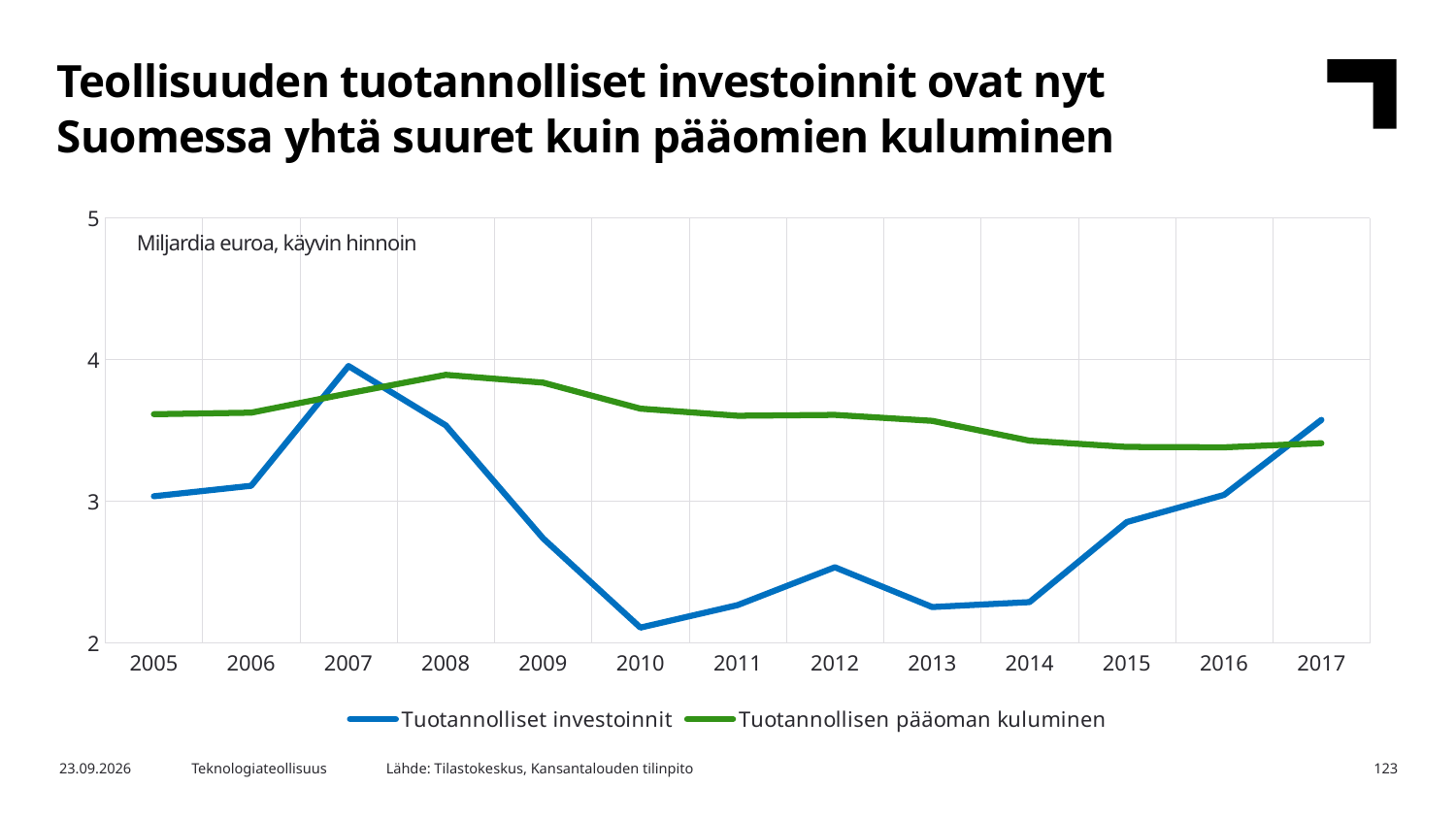
What unit is stated in the label inside the chart area? Miljardia euroa, käyvin hinnoin In which year does the Tuotannollisen pääoman kuluminen series reach its highest value? 2008 How many series does the legend list? 2 Is the value for Tuotannolliset investoinnit in 2010 greater or less than 3? less In which year does the Tuotannolliset investoinnit series reach its lowest value? 2010 Does the Tuotannolliset investoinnit series rise or fall from 2014 to 2017? rise Is the value for Tuotannollisen pääoman kuluminen in 2008 greater or less than 4? less In which year does the Tuotannolliset investoinnit series reach its highest value? 2007 How many years are plotted along the x axis? 13 Is the value for Tuotannolliset investoinnit in 2007 greater or less than 3? greater In 2012, which series has the larger value, Tuotannolliset investoinnit or Tuotannollisen pääoman kuluminen? Tuotannollisen pääoman kuluminen What kind of chart is shown on the slide? line chart